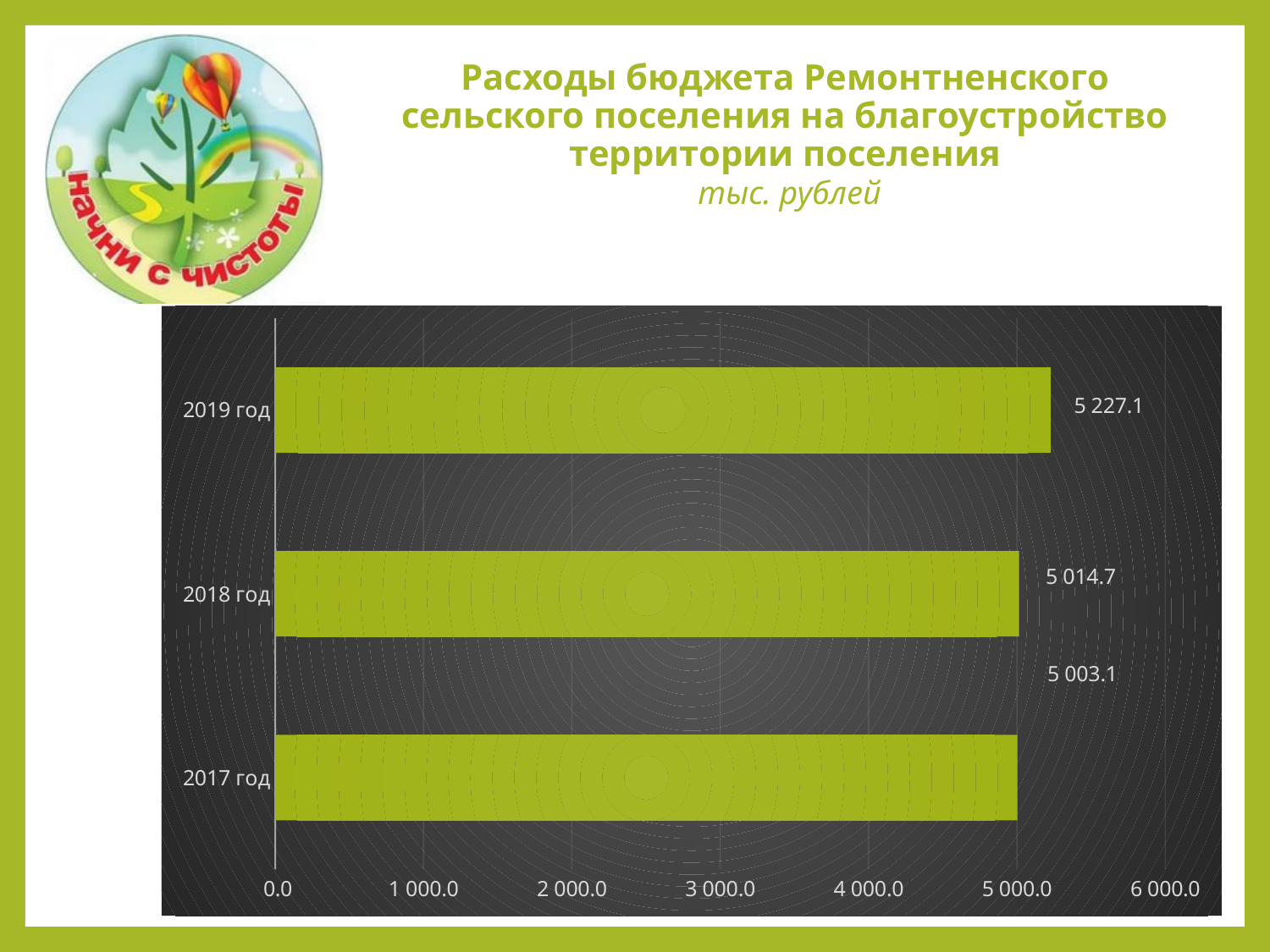
What is the difference between the values for 2019 год and 2017 год? 224.0 How many years (categories) are shown on the chart? 3 What is the difference between the values for 2019 год and 2018 год? 212.4 What is the budget expenditure value shown for 2019 год? 5 227.1 Which is larger, the value for 2018 год or the value for 2017 год? 2018 год Which year has the highest expenditure on the chart? 2019 год Which year has the lowest expenditure on the chart? 2017 год What type of chart is shown on the slide? bar chart Do the expenditure values rise or fall from 2017 год to 2019 год? rise Is the value for 2019 год greater or less than 5 000.0? greater What is the value shown for 2018 год? 5 014.7 What is the value shown for 2017 год? 5 003.1